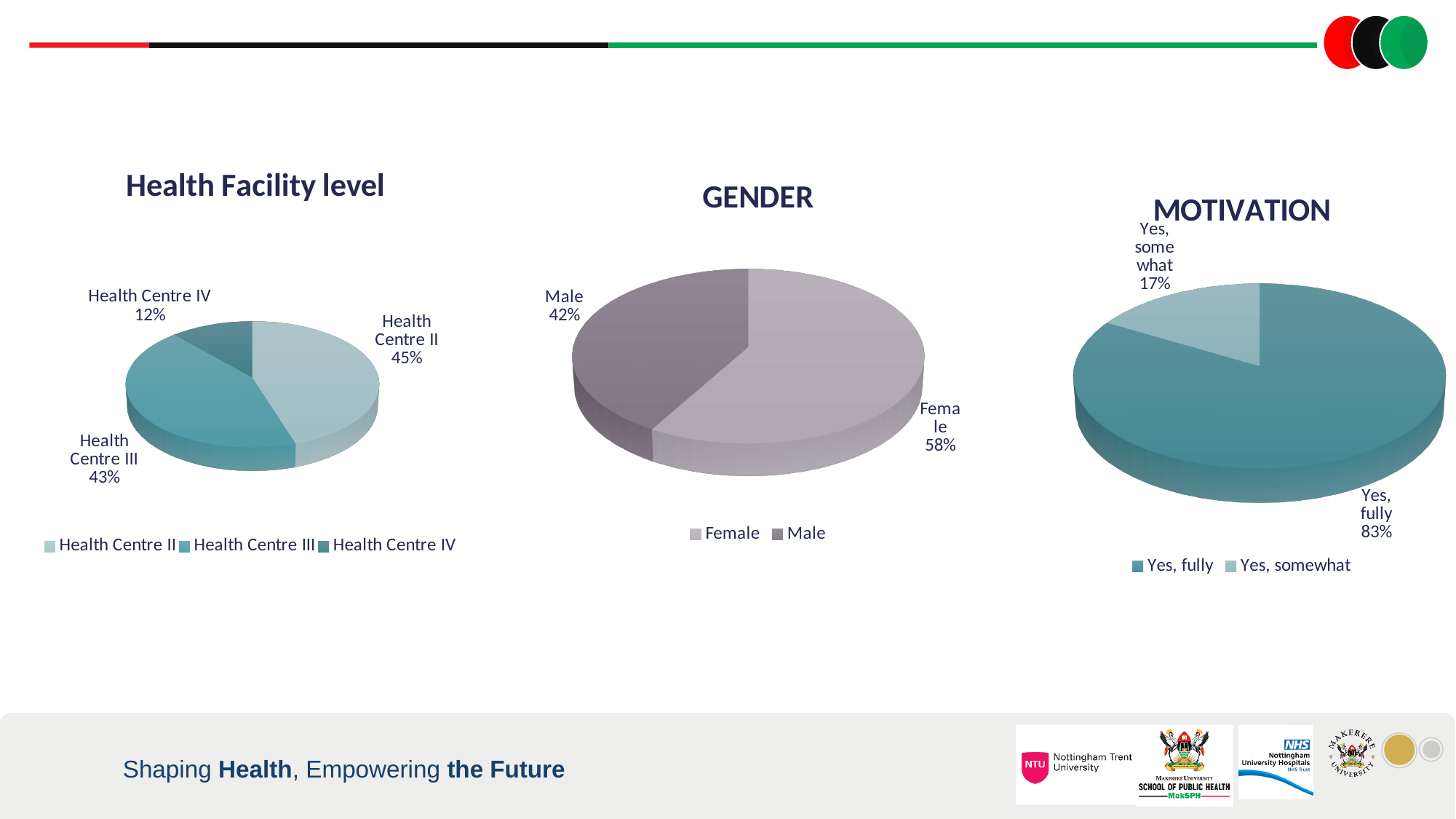
In the 'GENDER' chart, what share is Female? 58% In the 'Health Facility level' chart, how many categories does the legend list? 3 In the 'GENDER' chart, what is the difference in percentage points between Female and Male? 16 In the 'Health Facility level' chart, what share is Health Centre IV? 12% In the 'Health Facility level' chart, which facility level has the smallest share? Health Centre IV How many charts are shown on the slide? 3 In the 'MOTIVATION' chart, what share is 'Yes, somewhat'? 17% In the 'GENDER' chart, which is larger, Male or Female? Female In the 'MOTIVATION' chart, what share is 'Yes, fully'? 83% In the 'Health Facility level' chart, what share is Health Centre II? 45% What kind of chart is the 'MOTIVATION' chart? Pie chart In the 'Health Facility level' chart, what is the difference in percentage points between Health Centre II and Health Centre III? 2